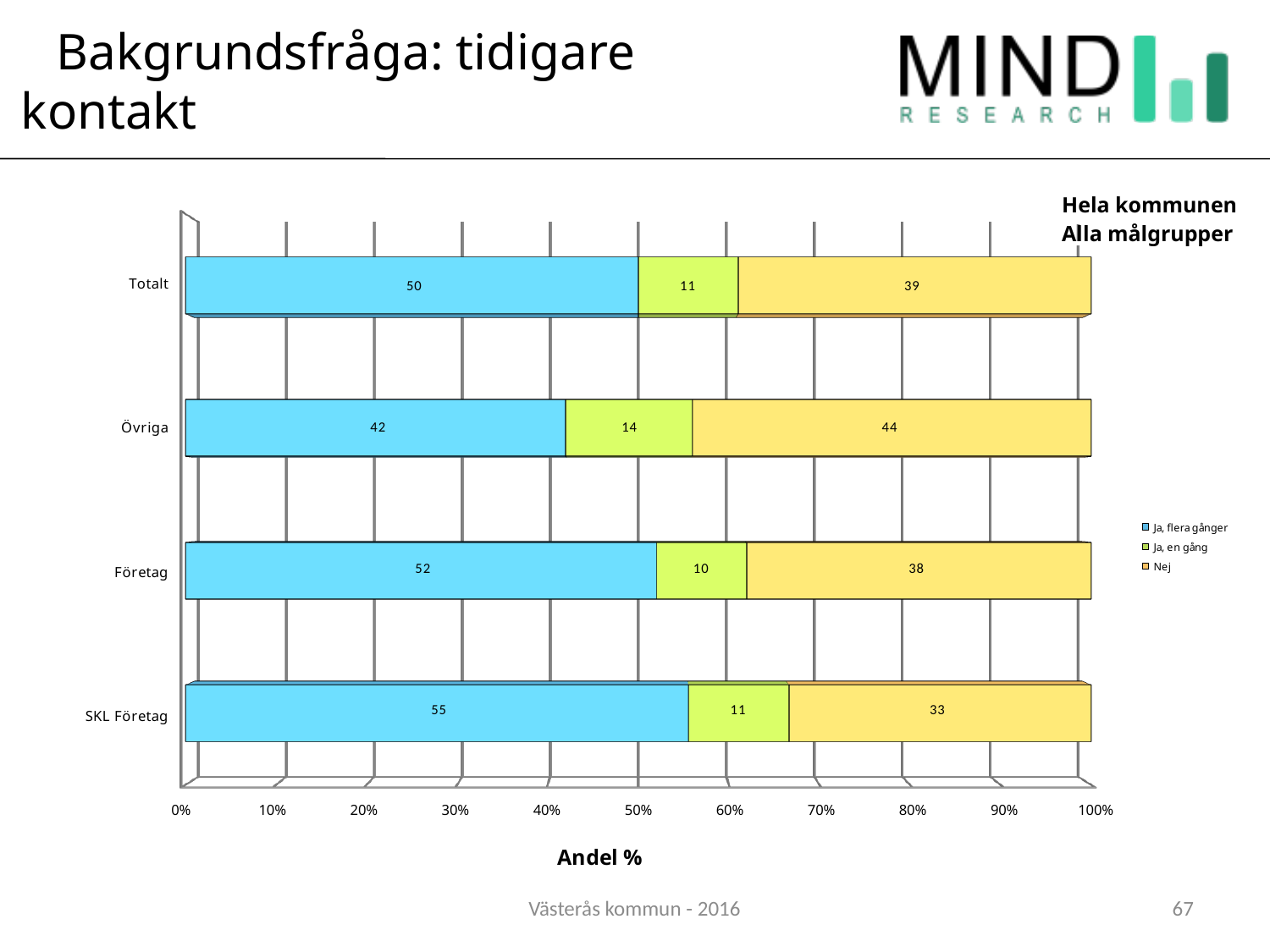
What is the value of "Ja, flera gånger" for SKL Företag? 55 What is the value of "Ja, flera gånger" for Totalt? 50 How many categories are shown on the y axis? 4 What is the label of the x axis? Andel % How many series does the legend list? 3 What is the difference between the "Nej" values for Övriga and SKL Företag? 11 What kind of chart is shown on the slide? Stacked bar chart Which category has the highest value for "Ja, flera gånger"? SKL Företag Which category has the lowest value for "Nej"? SKL Företag Which is larger: "Ja, en gång" for Övriga or "Ja, en gång" for Företag? Övriga What is the value of "Nej" for Övriga? 44 What is the value of "Ja, en gång" for Företag? 10